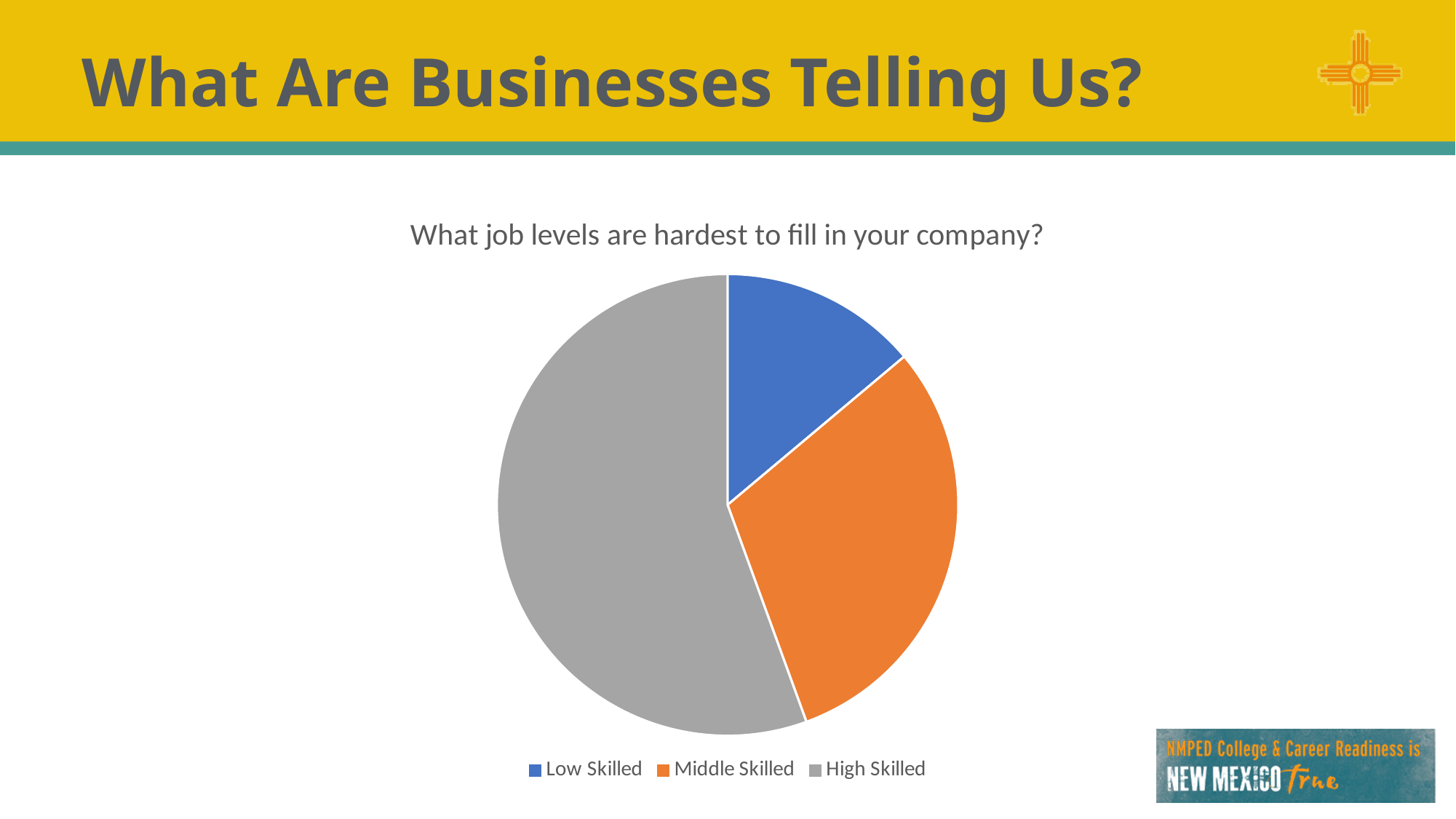
What kind of chart is shown on the slide? pie chart Which slice is larger, Middle Skilled or Low Skilled? Middle Skilled What is the title of the chart? What job levels are hardest to fill in your company? How many entries does the legend list? 3 How many slices does the pie chart have? 3 Which slice is larger, High Skilled or Middle Skilled? High Skilled Which colour represents the Middle Skilled slice? orange Which job level has the largest slice of the pie? High Skilled Which job level has the smallest slice of the pie? Low Skilled